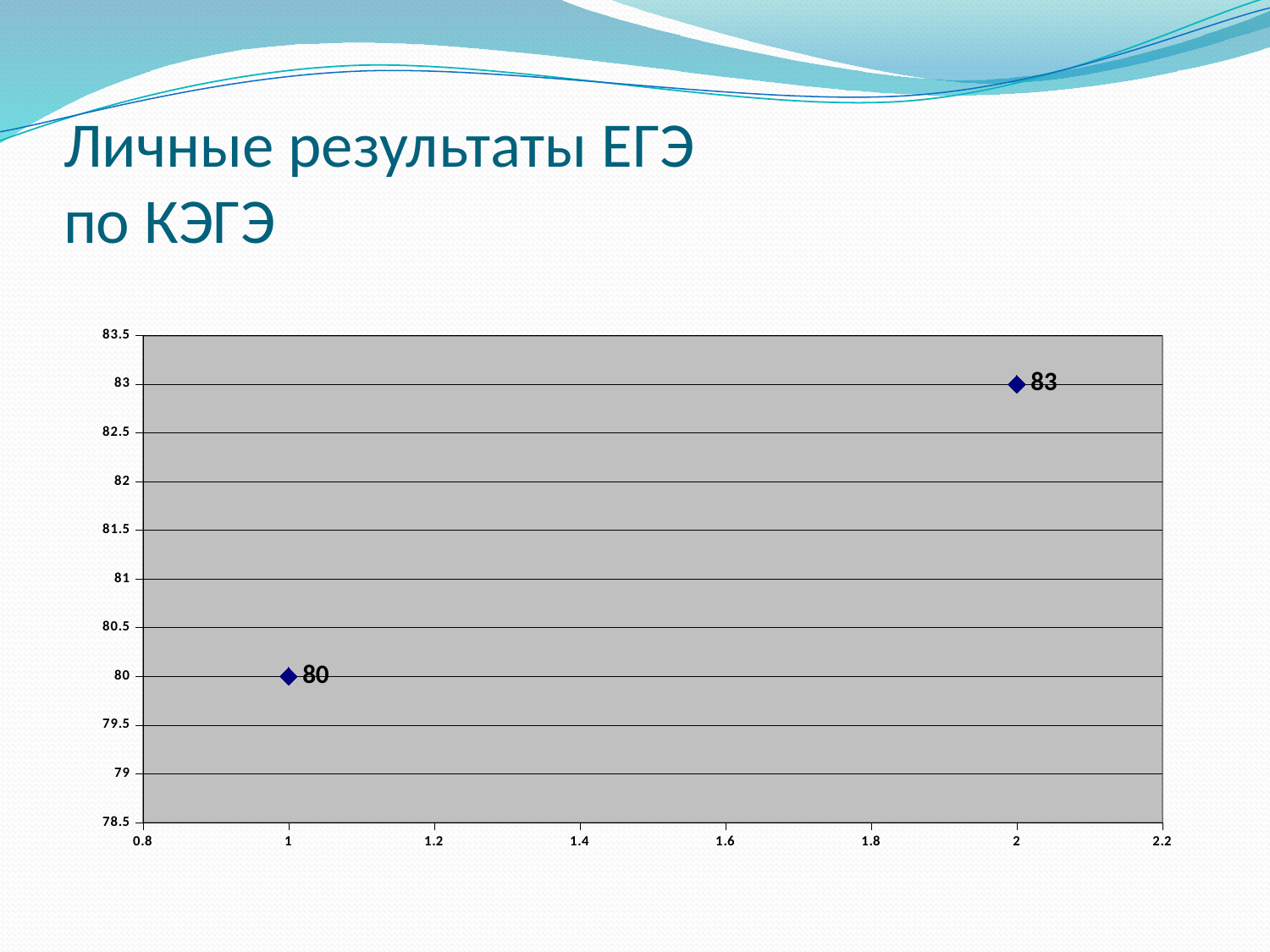
What kind of chart is shown on the slide? scatter chart Which data point has the lowest value, the one at x = 1 or the one at x = 2? x = 1 Do the values rise or fall as x increases from 1 to 2? rise What is the value of the data point at x = 2? 83 Is the value at x = 2 larger or smaller than the value at x = 1? larger What is the value of the data point at x = 1? 80 Which data point has the highest value, the one at x = 1 or the one at x = 2? x = 2 What is the difference between the value at x = 2 and the value at x = 1? 3 What is the title of the slide containing the chart? Личные результаты ЕГЭ по КЭГЭ Is the value at x = 1 greater or less than 81? less How many data points are plotted on the chart? 2 Is the value at x = 2 greater or less than 82? greater